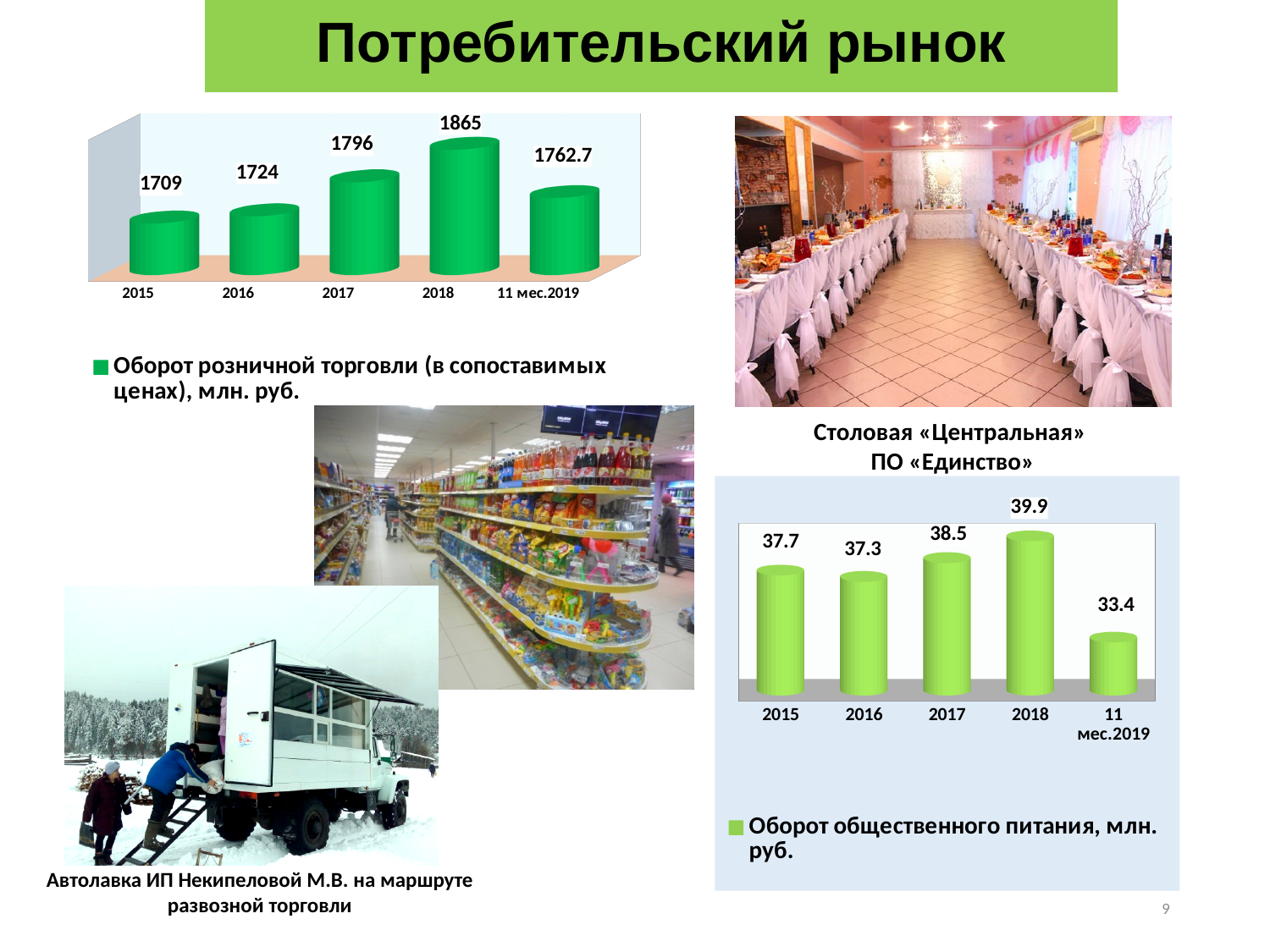
In the bottom-right chart (Оборот общественного питания), which is larger: the value for 2017 or the value for 2015? 2017 What type of chart is the bottom-right chart (Оборот общественного питания)? Bar chart In the top-left chart (Оборот розничной торговли), what is the value for 11 мес.2019? 1762.7 In the top-left chart (Оборот розничной торговли), what is the difference between the 2018 and 2015 values? 156 In the bottom-right chart (Оборот общественного питания), what is the value for 2016? 37.3 In the top-left chart (Оборот розничной торговли), how many bars are plotted? 5 In the top-left chart (Оборот розничной торговли), which category has the lowest value? 2015 In the bottom-right chart (Оборот общественного питания), which category has the lowest value? 11 мес.2019 In the top-left chart (Оборот розничной торговли), which year has the highest value? 2018 In the bottom-right chart (Оборот общественного питания), what is the value for 2018? 39.9 In the top-left chart (Оборот розничной торговли), what is the value for 2017? 1796 In the bottom-right chart (Оборот общественного питания), what is the difference between the 2018 and 11 мес.2019 values? 6.5